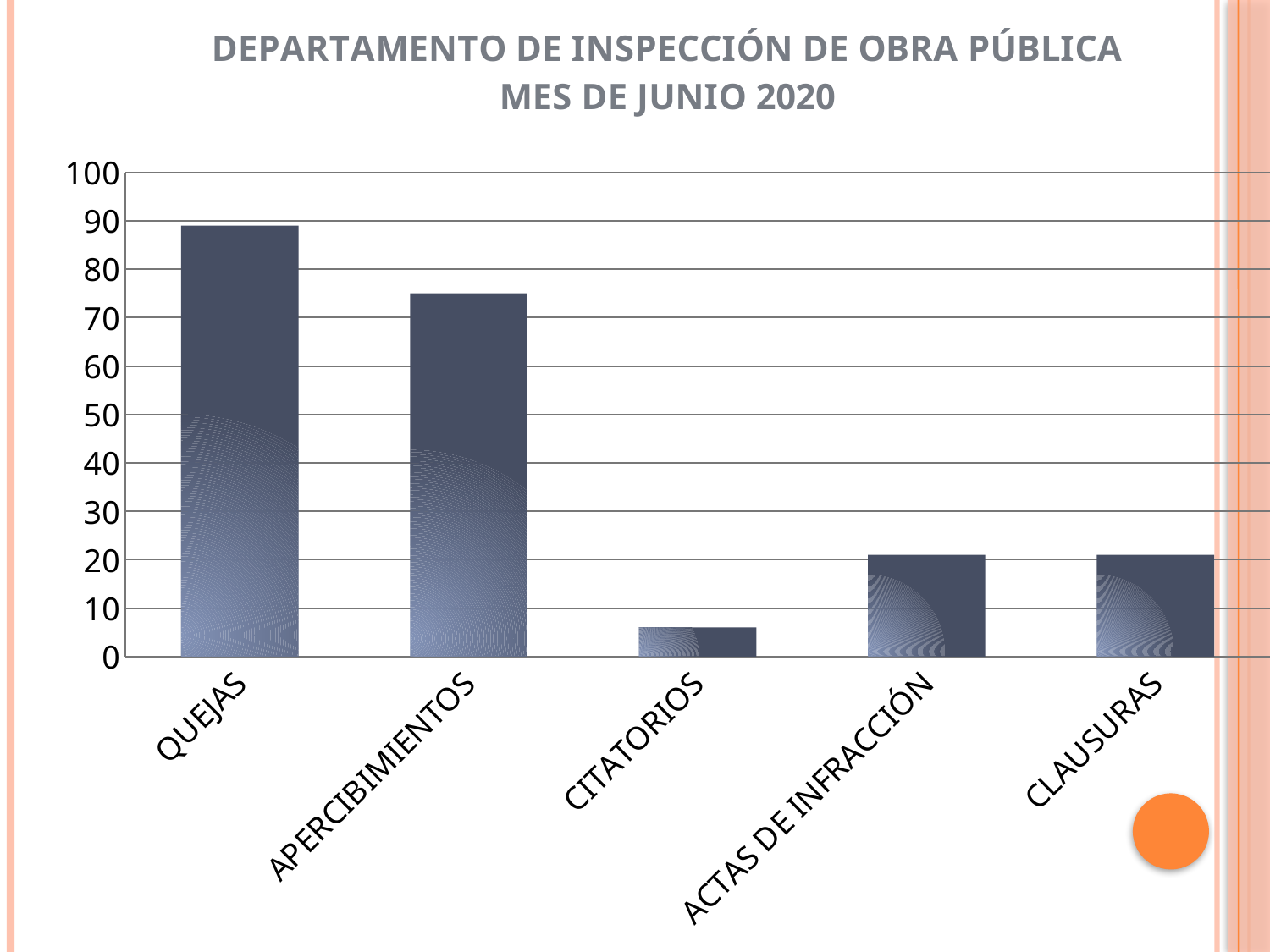
Which is larger, the value for QUEJAS or the value for APERCIBIMIENTOS? QUEJAS Which category has the highest value in the chart? QUEJAS Is the value for APERCIBIMIENTOS greater or less than 70? greater Which category has the lowest value in the chart? CITATORIOS Is the value for QUEJAS greater or less than 80? greater What type of chart is shown on the slide? bar chart Is the value for CITATORIOS greater or less than 10? less How many categories are shown on the x axis of the chart? 5 What is the title of the chart? DEPARTAMENTO DE INSPECCIÓN DE OBRA PÚBLICA MES DE JUNIO 2020 Which is larger, the value for CITATORIOS or the value for CLAUSURAS? CLAUSURAS